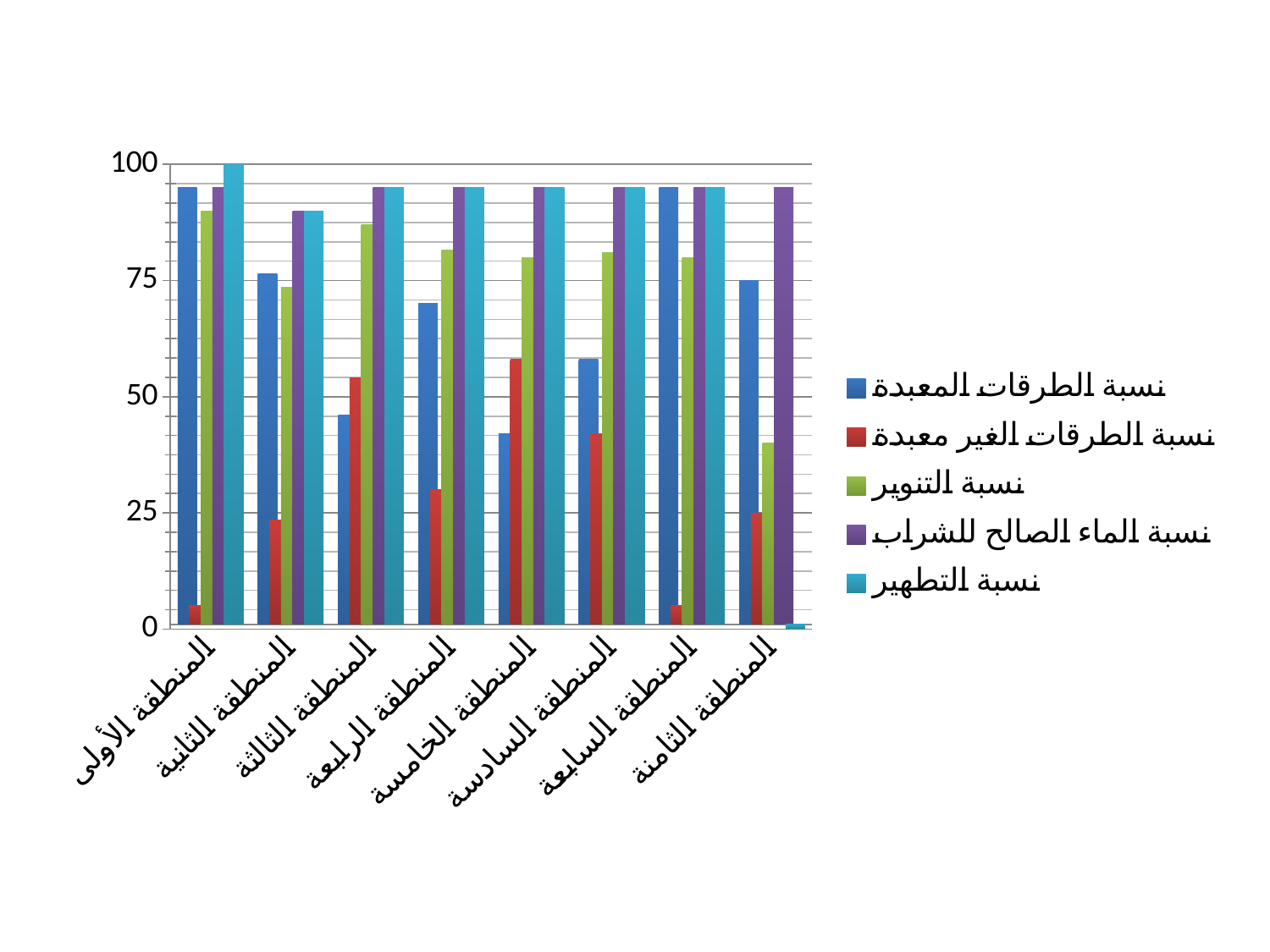
Which colour represents نسبة الماء الصالح للشراب in the legend? Purple What kind of chart is shown on the slide? Bar chart Is the value of نسبة الطرقات الغير معبدة for المنطقة الأولى greater or less than 25? less Is the value of نسبة التنوير for المنطقة الثامنة greater or less than 50? less Which region has the highest value for نسبة التطهير? المنطقة الأولى How many series does the legend list? 5 Which is larger: نسبة الطرقات المعبدة for المنطقة الأولى or for المنطقة الخامسة? المنطقة الأولى Is the value of نسبة الطرقات الغير معبدة for المنطقة الخامسة greater or less than 50? greater How many regions (categories) are shown on the x axis? 8 Which region has the lowest value for نسبة التنوير? المنطقة الثامنة What is the value of نسبة التطهير for المنطقة الأولى? 100 Which region has the lowest value for نسبة التطهير? المنطقة الثامنة